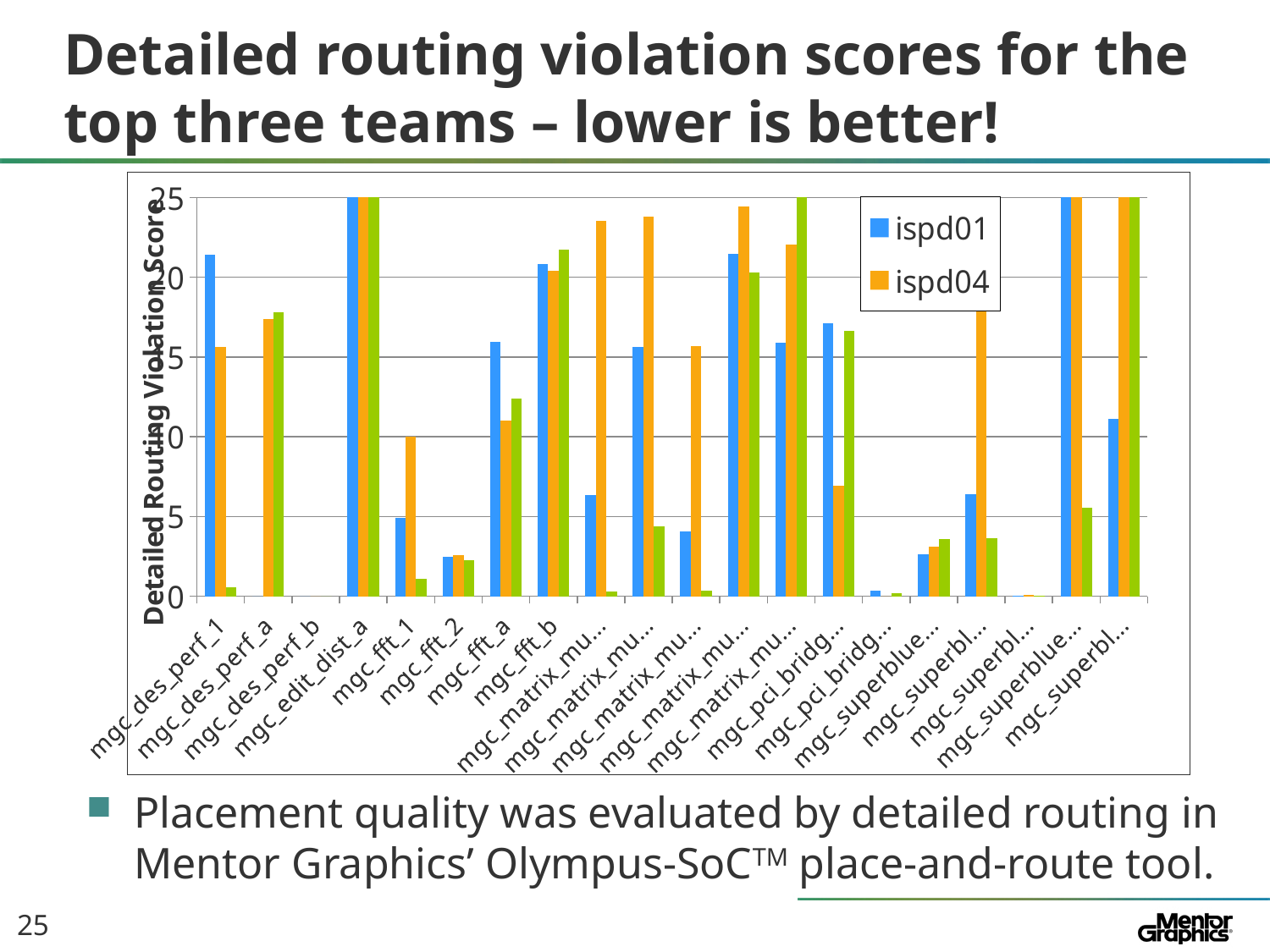
Is the ispd01 value for mgc_fft_2 greater or less than 5? less Is the ispd01 value for mgc_des_perf_1 greater or less than 20? greater What kind of chart is shown on the slide? bar chart For mgc_fft_a, which series has the larger value, ispd01 or ispd04? ispd01 What colour represents the ispd01 series in the legend? blue What is the title of the vertical axis? Detailed Routing Violation Score For mgc_des_perf_1, which series has the larger value, ispd01 or ispd04? ispd01 How many categories are shown along the x axis of the chart? 20 Is the ispd04 value for mgc_des_perf_a greater or less than 15? greater How many entries does the chart's legend list? 2